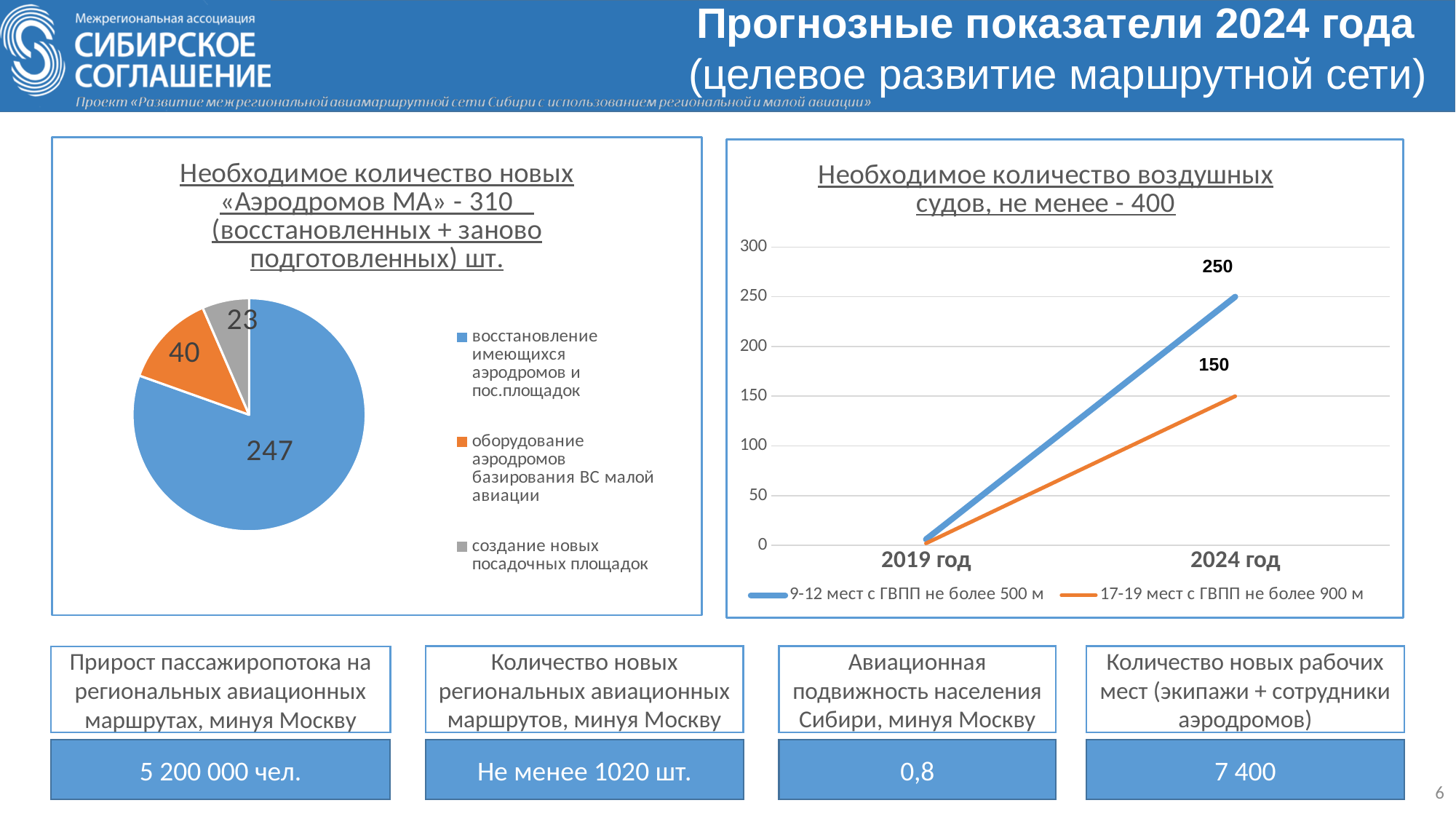
In the left pie chart, what is the value for "оборудование аэродромов базирования ВС малой авиации"? 40 In the right line chart, how many series does the legend list? 2 In the right chart ("Необходимое количество воздушных судов"), what kind of chart is shown? line chart In the right line chart, what is the value for "17-19 мест с ГВПП не более 900 м" in 2024 год? 150 In the left chart ("Необходимое количество новых «Аэродромов МА»"), what kind of chart is shown? pie chart In the left pie chart, how many slices are there? 3 In the right line chart, what is the value for "9-12 мест с ГВПП не более 500 м" in 2024 год? 250 In the left pie chart, what is the difference between the values for "оборудование аэродромов базирования ВС малой авиации" and "создание новых посадочных площадок"? 17 In the left pie chart, what is the value for "создание новых посадочных площадок"? 23 In the left pie chart, which category has the smallest slice? создание новых посадочных площадок In the left pie chart, what is the value for "восстановление имеющихся аэродромов и пос.площадок"? 247 In the left pie chart, which category has the largest slice? восстановление имеющихся аэродромов и пос.площадок